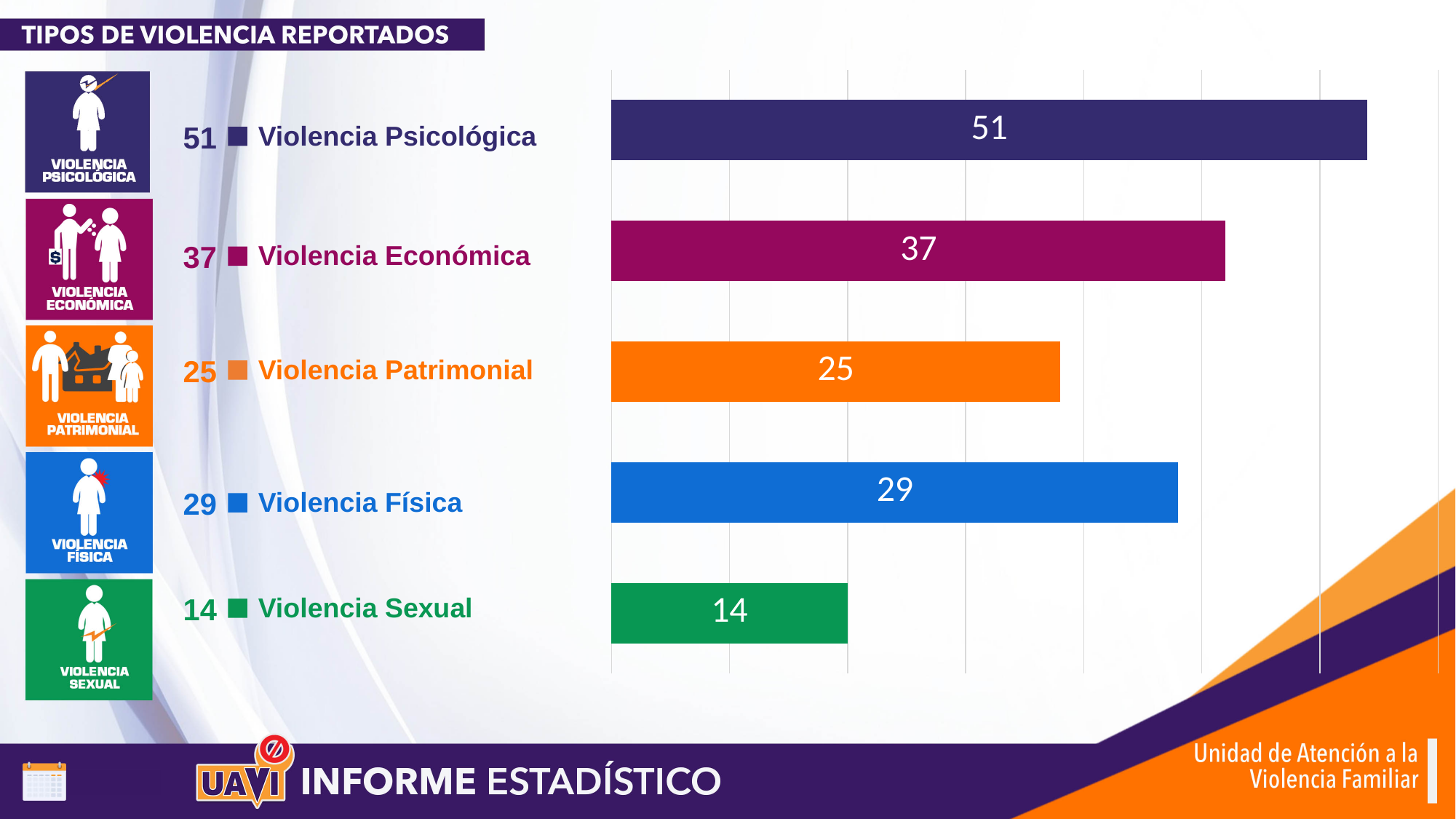
What is the title of the chart? TIPOS DE VIOLENCIA REPORTADOS What kind of chart is shown on the slide? Bar chart How many types of violence are shown in the chart? 5 What is the difference between the values for Violencia Física and Violencia Patrimonial? 4 What is the value for Violencia Sexual? 14 Which is larger, the value for Violencia Física or the value for Violencia Patrimonial? Violencia Física Which type of violence has the highest reported value? Violencia Psicológica What is the difference between the values for Violencia Psicológica and Violencia Económica? 14 Which type of violence has the lowest reported value? Violencia Sexual What colour is the bar for Violencia Patrimonial? Orange What is the value for Violencia Psicológica? 51 What is the value for Violencia Económica? 37